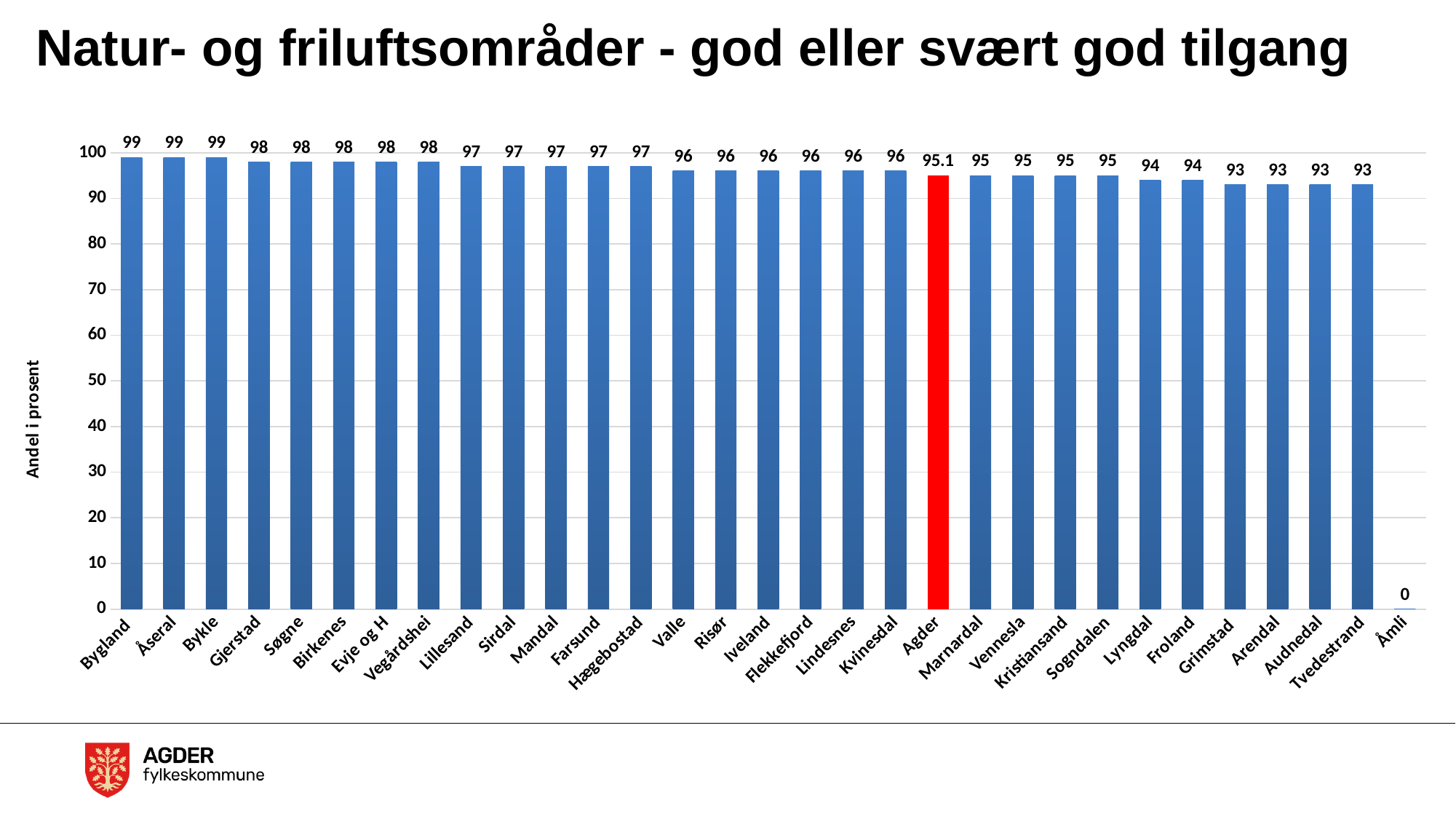
Which is larger, the value for Lillesand or the value for Lyngdal? Lillesand Which bar is coloured red? Agder Which category has the lowest value? Åmli What is the value for Gjerstad? 98 How many categories are shown on the x axis? 31 What is the label of the y axis? Andel i prosent What is the value for Tvedestrand? 93 Is the value for Arendal greater or less than 90? greater What is the value for Agder? 95.1 What is the difference between the values for Bygland and Grimstad? 6 What is the value for Kristiansand? 95 What kind of chart is shown on the slide? Bar chart